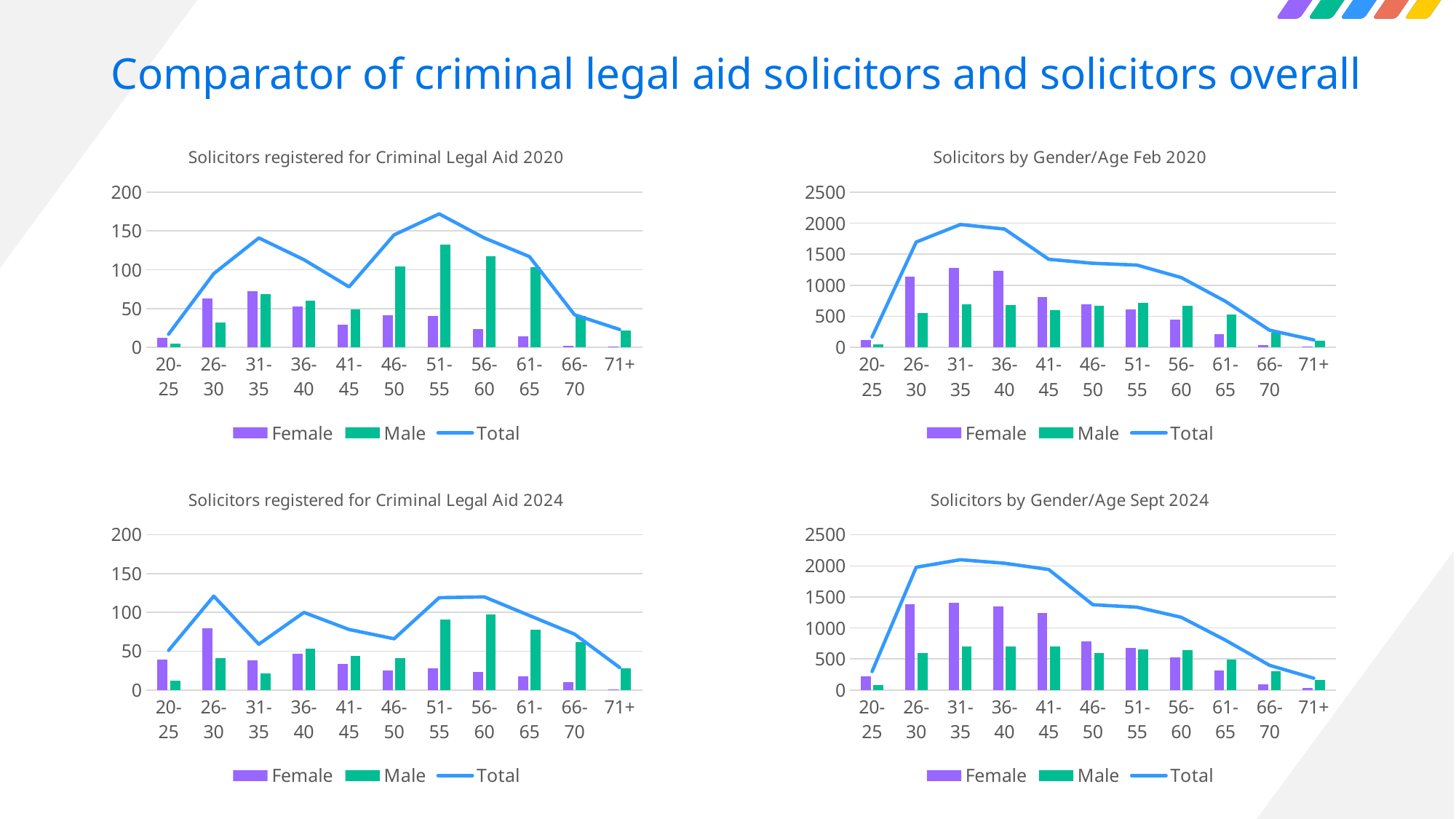
In the chart titled "Solicitors by Gender/Age Sept 2024", does the Total line rise or fall from the 41-45 age group to the 71+ age group? fall In the chart titled "Solicitors registered for Criminal Legal Aid 2024", which age group has the highest Female value? 26-30 In the chart titled "Solicitors by Gender/Age Feb 2020", is the Male value for 31-35 greater or less than 1000? less In the chart titled "Solicitors registered for Criminal Legal Aid 2020", which age group has the highest Male value? 51-55 In the chart titled "Solicitors registered for Criminal Legal Aid 2020", is the Male value for 51-55 greater or less than 100? greater In the chart titled "Solicitors registered for Criminal Legal Aid 2024", is the Male value for 20-25 greater or less than 50? less How many age categories are shown on the x axis of the chart titled "Solicitors by Gender/Age Feb 2020"? 11 In the chart titled "Solicitors by Gender/Age Feb 2020", which age group has the highest Female value? 31-35 How many series does the legend list in the chart titled "Solicitors registered for Criminal Legal Aid 2020"? 3 In the chart titled "Solicitors registered for Criminal Legal Aid 2020", which is larger for the 56-60 age group, Female or Male? Male In the chart titled "Solicitors by Gender/Age Feb 2020", which is larger for the 26-30 age group, Female or Male? Female